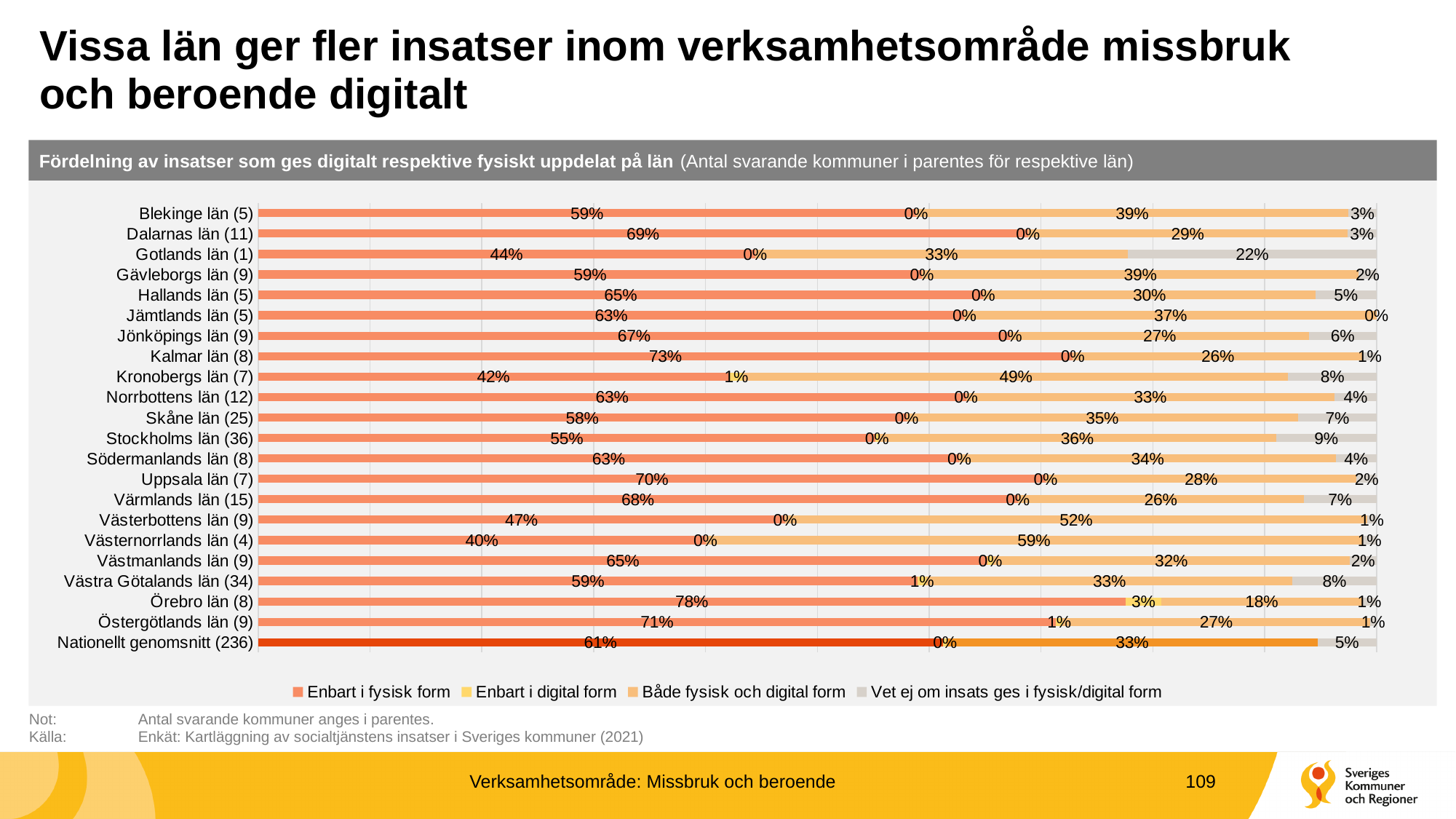
Which category has the highest value for 'Enbart i fysisk form'? Örebro län (8) How many categories (rows) are plotted in the chart? 22 What is the value of 'Både fysisk och digital form' for Nationellt genomsnitt (236)? 33% What is the value of 'Vet ej om insats ges i fysisk/digital form' for Gotlands län (1)? 22% Which category has the lowest value for 'Enbart i fysisk form'? Västernorrlands län (4) What is the value of 'Enbart i digital form' for Örebro län (8)? 3% What is the value of 'Enbart i fysisk form' for Kalmar län (8)? 73% Which has a larger 'Enbart i fysisk form' value, Kalmar län (8) or Stockholms län (36)? Kalmar län (8) What kind of chart is shown on the slide? Stacked bar chart Which category has the highest value for 'Både fysisk och digital form'? Västernorrlands län (4) What is the difference in 'Enbart i fysisk form' between Örebro län (8) and Västernorrlands län (4)? 38 percentage points How many series does the legend list? 4